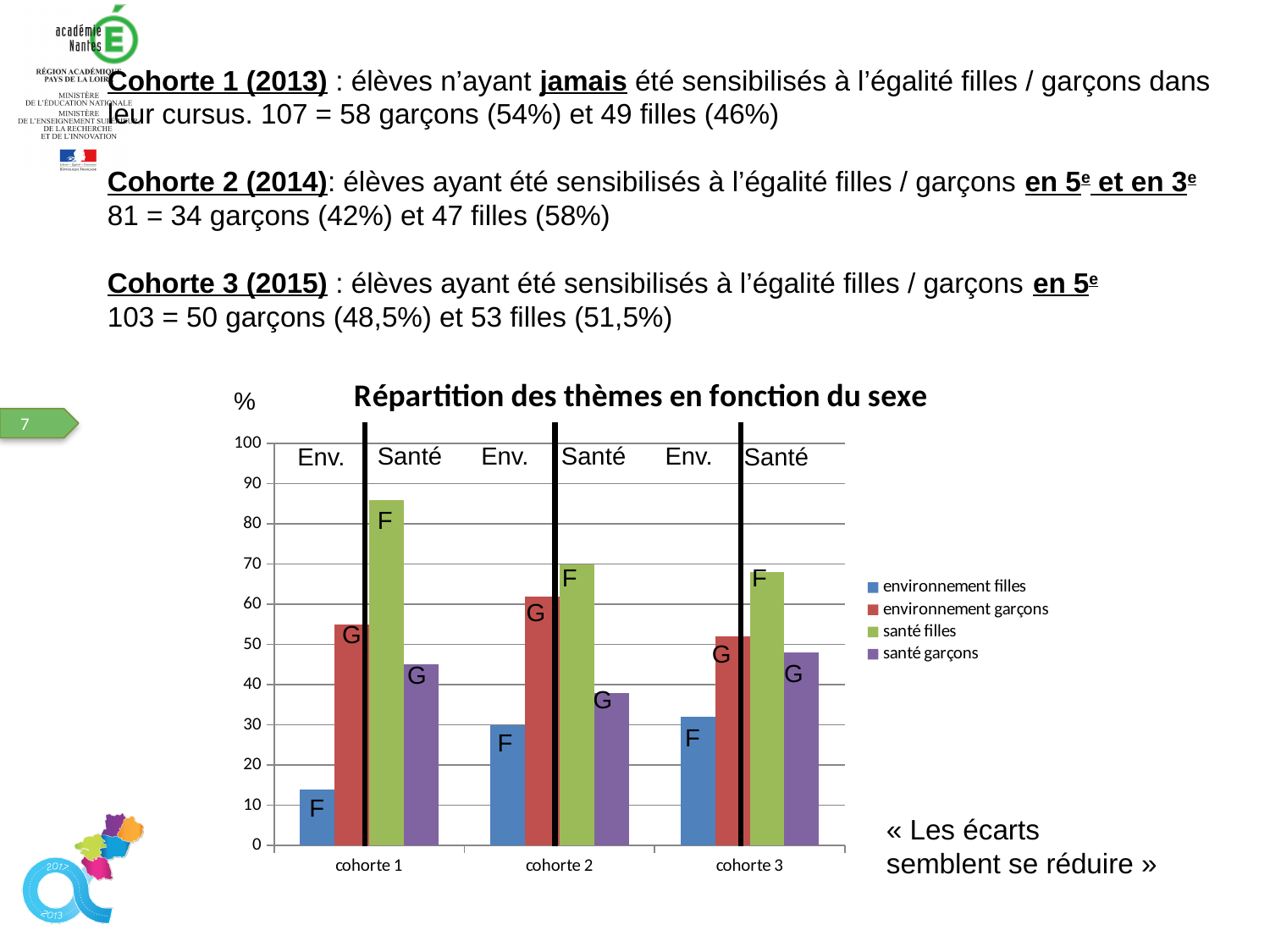
Is the value for environnement filles in cohorte 1 greater or less than 20? less What is the title of the chart? Répartition des thèmes en fonction du sexe In cohorte 3, which is larger: santé filles or santé garçons? santé filles Does the value for environnement filles rise or fall from cohorte 1 to cohorte 3? rise Which cohort has the highest value for santé filles? cohorte 1 Which legend entry is shown in green? santé filles How many series does the chart legend list? 4 Which cohort has the lowest value for environnement filles? cohorte 1 What kind of chart is shown on the slide? bar chart Is the value for santé garçons in cohorte 2 greater or less than 40? less How many cohort categories are shown on the x axis of the chart? 3 Is the value for santé filles in cohorte 1 greater or less than 80? greater